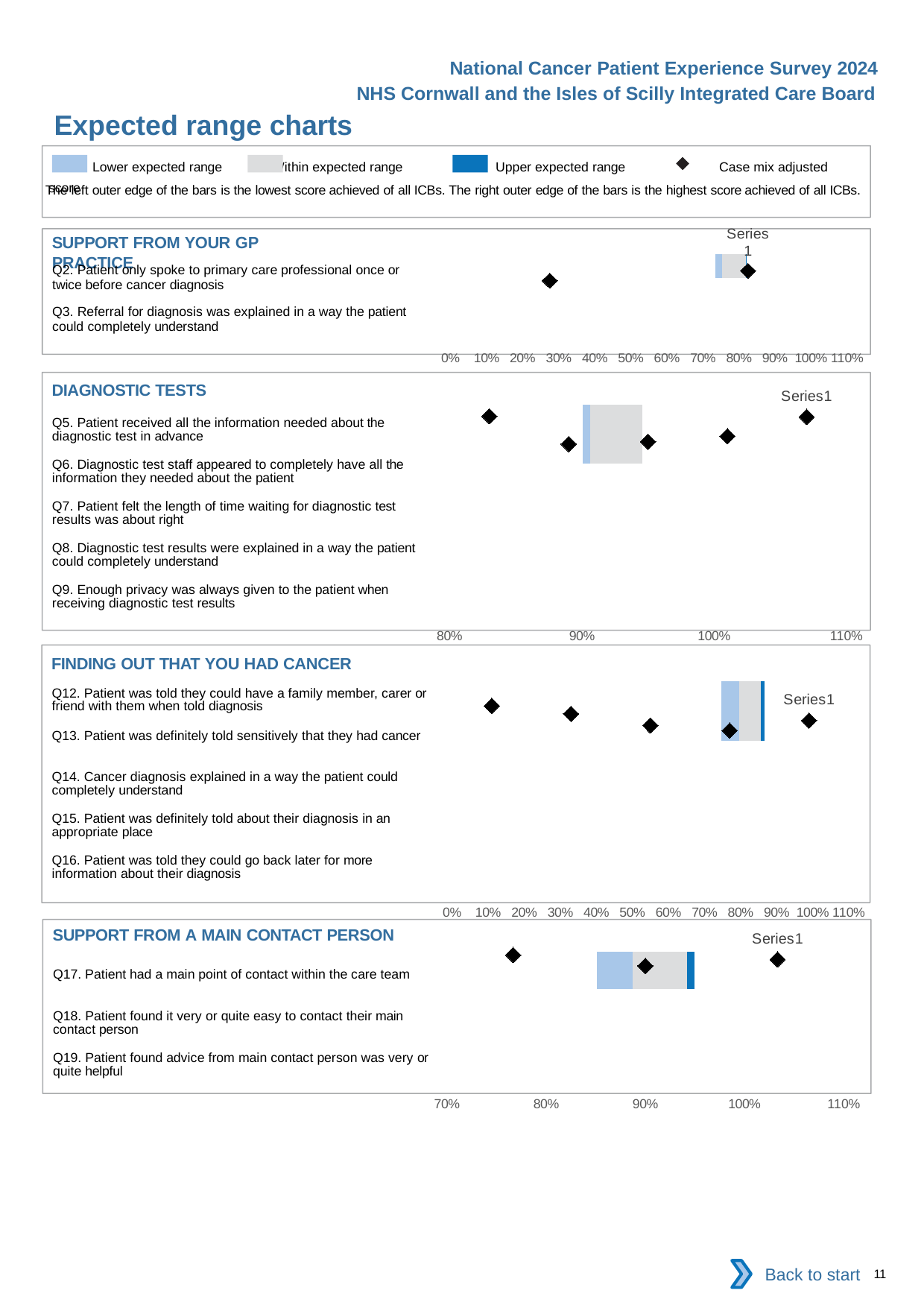
How many questions are listed in the DIAGNOSTIC TESTS chart? 5 In the SUPPORT FROM A MAIN CONTACT PERSON chart, are all the plotted case mix adjusted scores greater or less than 70%? greater What symbol does the legend use for the case mix adjusted score? A black diamond How many questions are listed in the SUPPORT FROM A MAIN CONTACT PERSON chart? 3 How many questions are listed in the FINDING OUT THAT YOU HAD CANCER chart? 5 In the DIAGNOSTIC TESTS chart, are all the plotted case mix adjusted scores greater or less than 80%? greater In the FINDING OUT THAT YOU HAD CANCER chart, is the leftmost plotted score greater or less than 50%? less How many entries does the legend at the top of the slide list? 4 Which chart has an x axis that starts at 70%? SUPPORT FROM A MAIN CONTACT PERSON